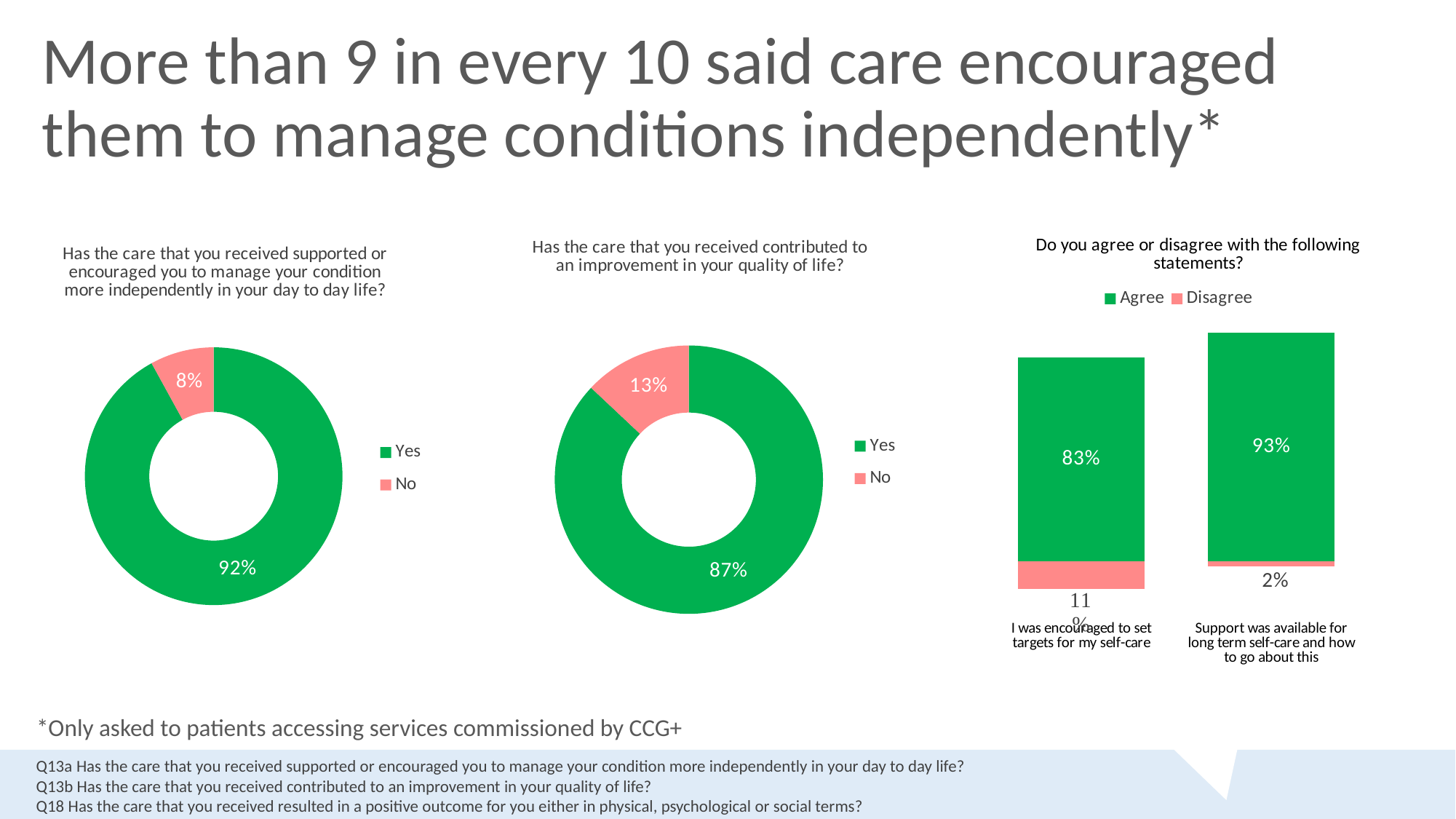
In the right chart, what percentage disagreed with 'I was encouraged to set targets for my self-care'? 11% In the right chart, 'Do you agree or disagree with the following statements?', what percentage agreed with 'Support was available for long term self-care and how to go about this'? 93% In the right chart, what percentage agreed with 'I was encouraged to set targets for my self-care'? 83% In the left chart, 'Has the care that you received supported or encouraged you to manage your condition more independently in your day to day life?', what percentage answered Yes? 92% What type of chart is the left chart about managing your condition more independently? Donut chart How many series does the legend of the right chart list? 2 What is the difference between the Yes percentage in the left chart (managing condition independently) and the Yes percentage in the middle chart (improvement in quality of life)? 5% In the right chart, which statement has the higher Agree percentage? Support was available for long term self-care and how to go about this In the middle chart, 'Has the care that you received contributed to an improvement in your quality of life?', what percentage answered Yes? 87% In the middle chart about improvement in quality of life, what percentage answered No? 13% What type of chart is the right chart, 'Do you agree or disagree with the following statements?' Stacked bar chart In the left chart about managing your condition more independently, what percentage answered No? 8%